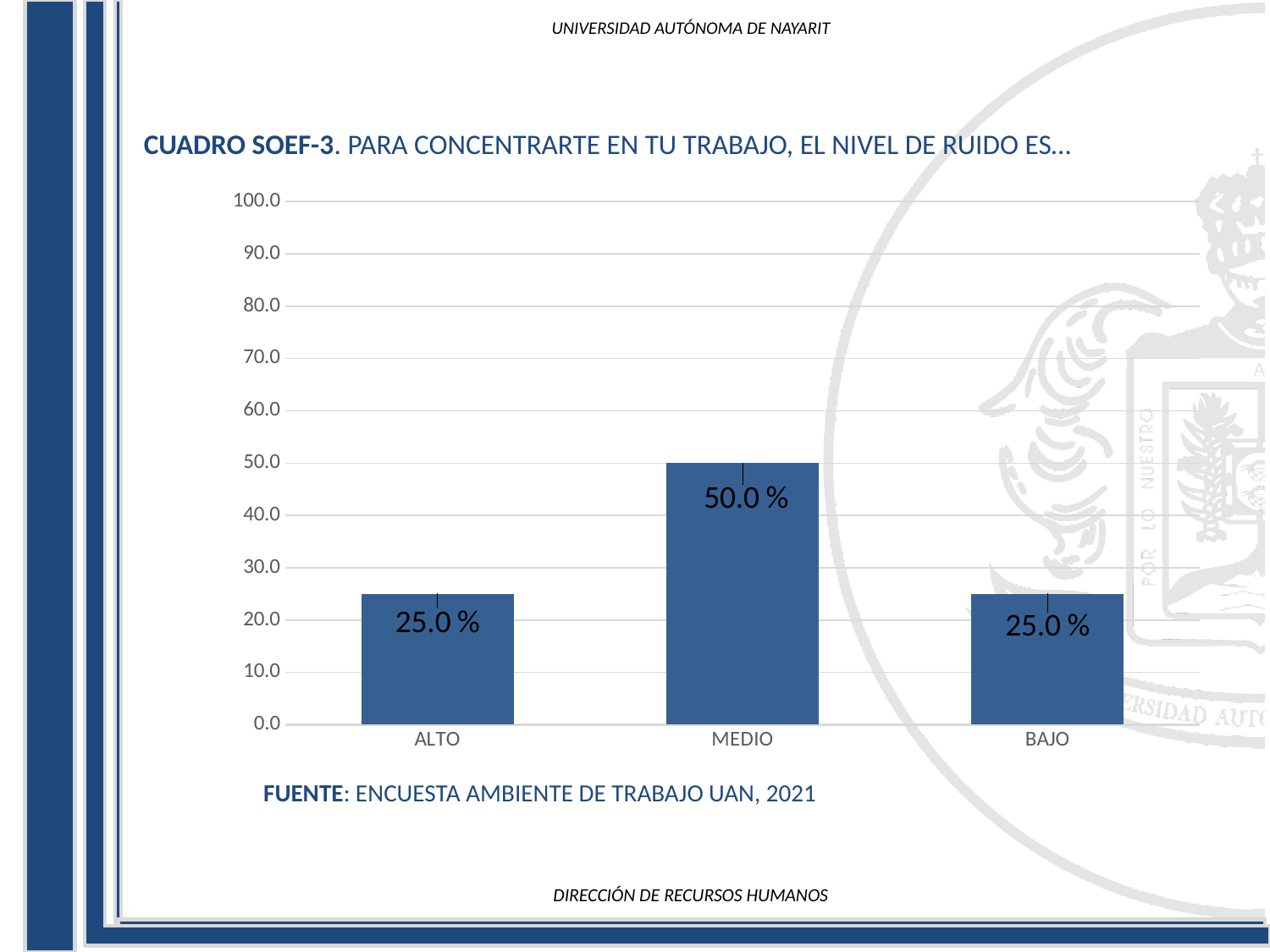
Is the value for ALTO greater or less than 30.0? less What is the value for ALTO? 25.0 % How many categories are shown on the x axis? 3 Is the value for MEDIO greater or less than 40.0? greater What is the source cited below the chart? ENCUESTA AMBIENTE DE TRABAJO UAN, 2021 What is the value for MEDIO? 50.0 % Which is larger, the value for MEDIO or the value for BAJO? MEDIO What is the difference between the values for MEDIO and ALTO? 25.0 % What is the value for BAJO? 25.0 % What is the title of the chart? CUADRO SOEF-3. PARA CONCENTRARTE EN TU TRABAJO, EL NIVEL DE RUIDO ES… What kind of chart is shown on the slide? bar chart Which category has the highest value? MEDIO